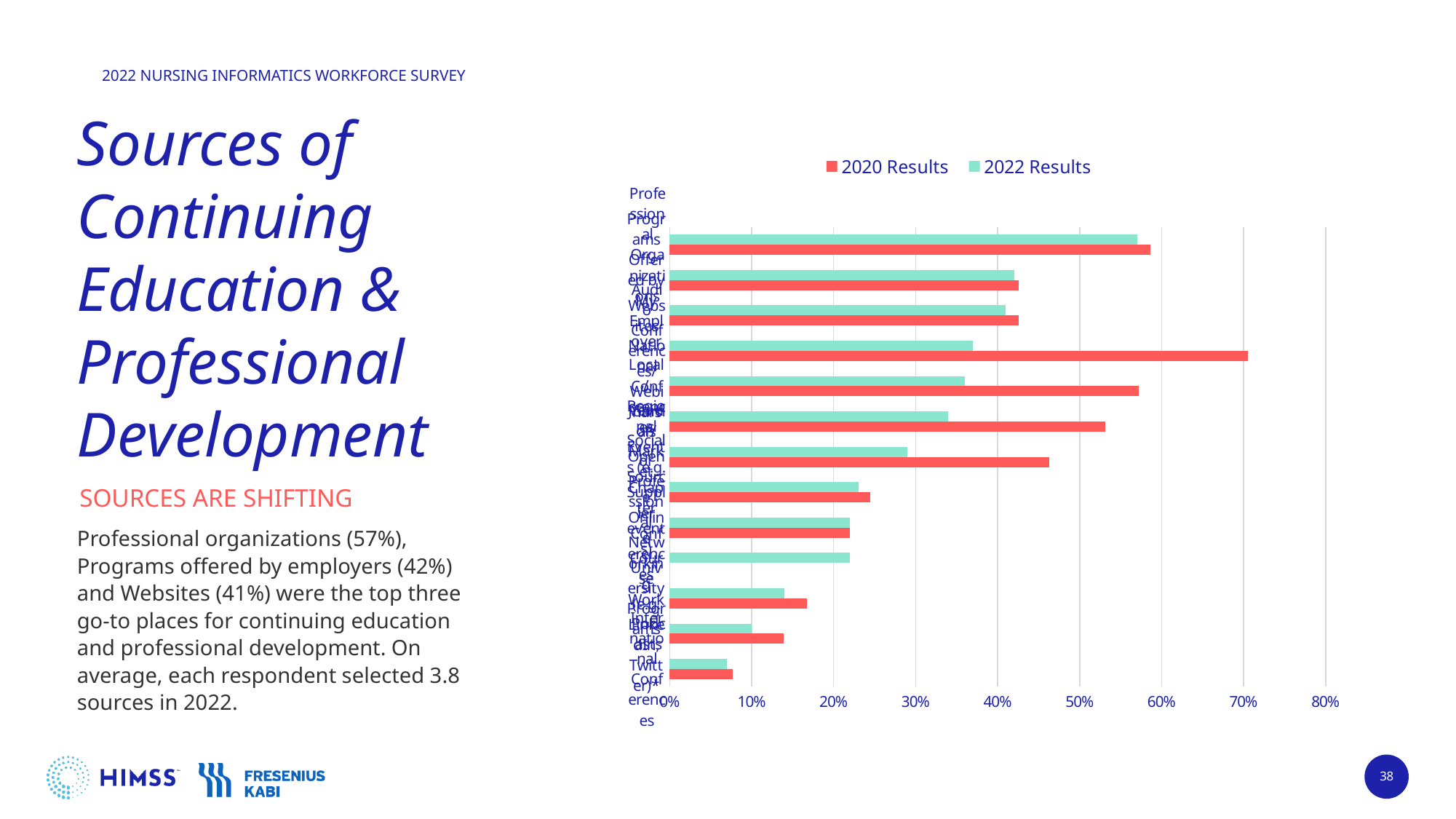
Which series contains the single longest bar in the chart? 2020 Results Is the longest 2020 Results bar in the chart greater or less than 60%? greater What kind of chart is shown on the slide? Bar chart For the fourth category from the top, which series has the larger value, 2020 Results or 2022 Results? 2020 Results Is the 2020 Results bar for the bottom category greater or less than 10%? less Which colour represents the 2020 Results series in the chart? Red How many series does the chart legend list? 2 What are the two series named in the chart legend? 2020 Results and 2022 Results Is the 2022 Results bar for the bottom category greater or less than 10%? less How many categories are plotted in the chart? 13